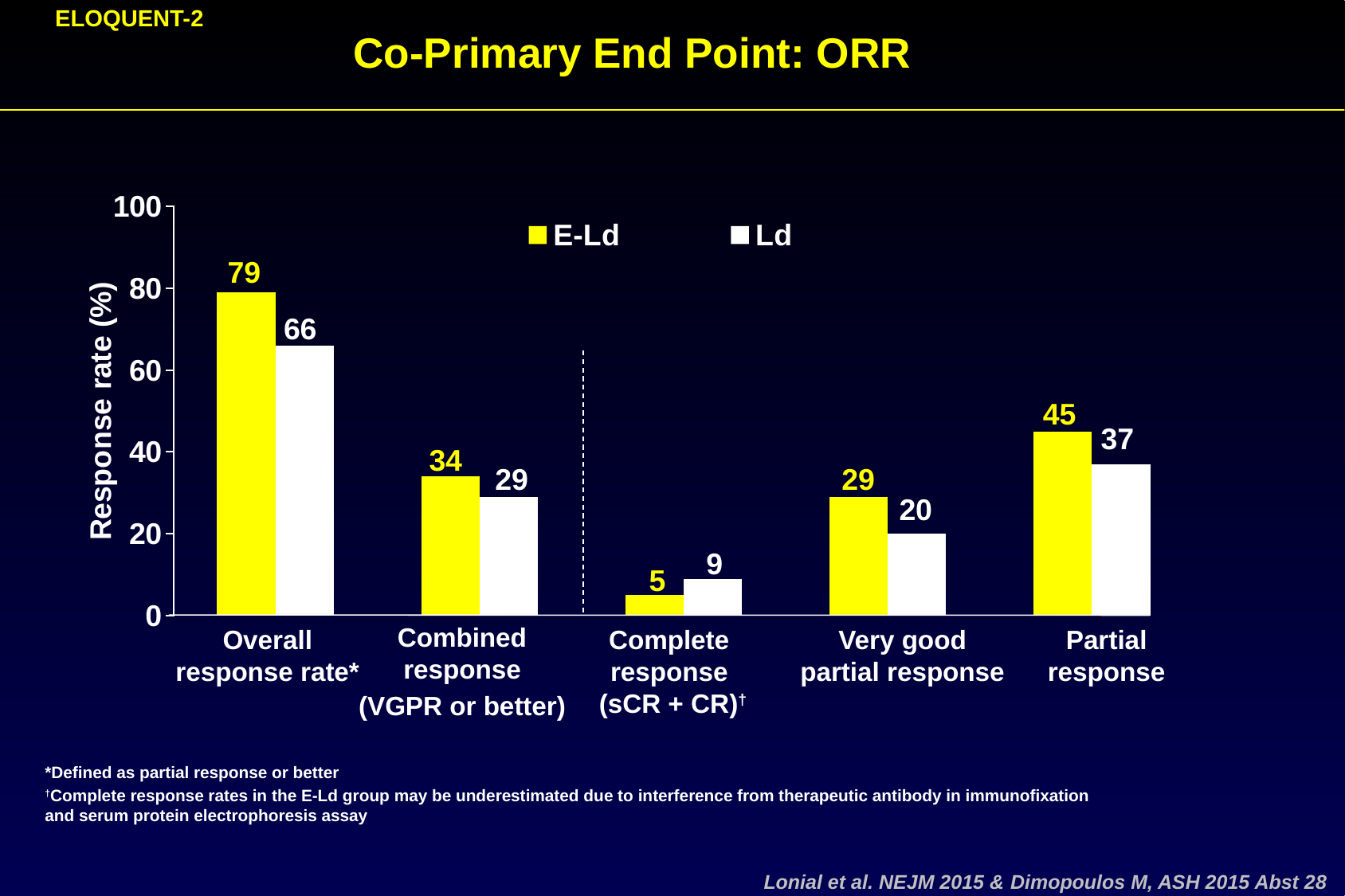
What is the value for Ld in the Complete response (sCR + CR) category? 9 In the Complete response (sCR + CR) category, which series has the larger value, E-Ld or Ld? Ld Which category has the lowest value for Ld? Complete response (sCR + CR) Which category has the highest value for E-Ld? Overall response rate* What is the difference between E-Ld and Ld for Partial response? 8 What is the overall response rate for E-Ld? 79 What is the difference between E-Ld and Ld in the Overall response rate category? 13 How many series does the legend list? 2 What is the Very good partial response rate for Ld? 20 How many categories are shown on the x axis? 5 What type of chart is shown on the slide? Bar chart Is the E-Ld value for Combined response (VGPR or better) greater or less than 40? less